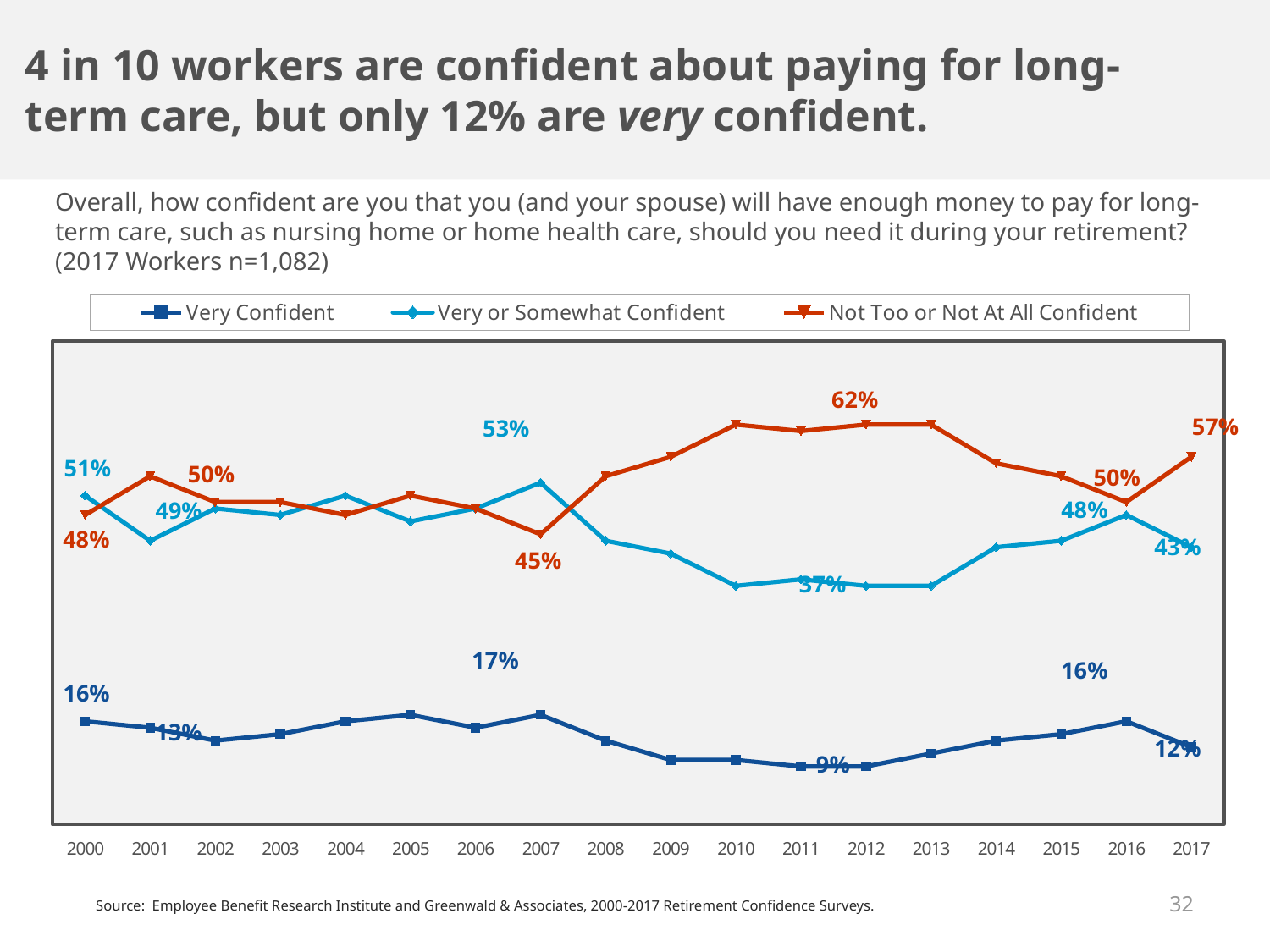
What is the value for Not Too or Not At All Confident in 2017? 57% What kind of chart is shown on the slide? line chart How many series does the legend list? 3 What is the value for Very Confident in 2017? 12% What is the value for Very or Somewhat Confident in 2000? 51% What is the value for Very Confident in 2007? 17% What is the value for Not Too or Not At All Confident in 2012? 62% Which series has the highest value in 2017? Not Too or Not At All Confident In 2000, which is larger: Very or Somewhat Confident or Not Too or Not At All Confident? Very or Somewhat Confident How many years are shown along the x axis? 18 In 2017, what is the difference between Not Too or Not At All Confident and Very or Somewhat Confident? 14 percentage points Does the Very Confident line rise or fall from 2007 to 2011? fall